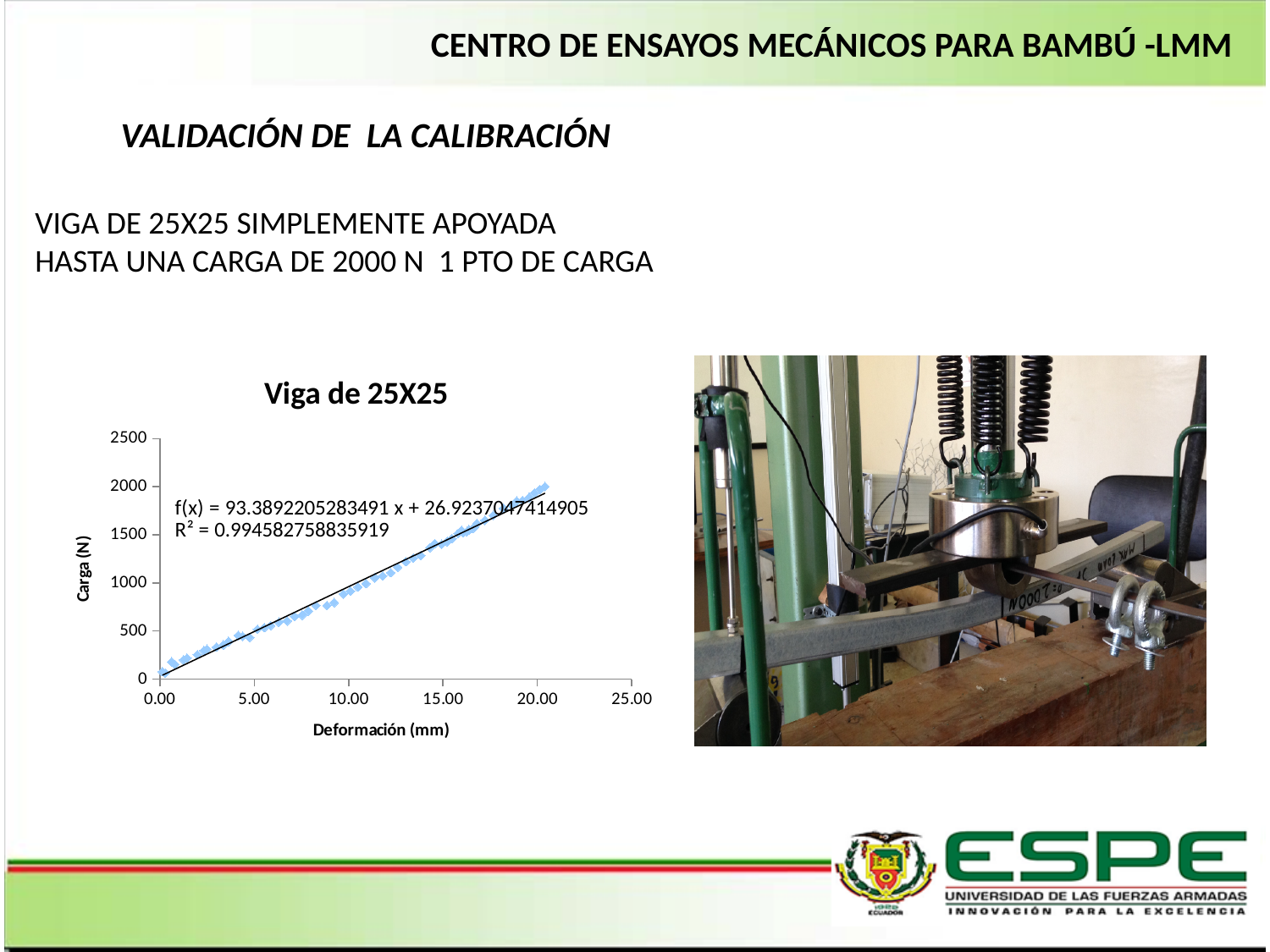
What kind of chart is shown on the slide? scatter chart What is the label of the x axis of the chart? Deformación (mm) What is the title of the chart? Viga de 25X25 What is the slope of the trendline equation shown on the chart? 93.3892205283491 What is the highest value shown on the y axis of the chart? 2500 What is the intercept of the trendline equation shown on the chart? 26.9237047414905 Is the load at a deformation of about 5 mm greater or less than 1000 N? less Is the load at a deformation of about 20 mm greater or less than 1500 N? greater Does the load (Carga) rise or fall as deformation increases along the x axis? rise Is the load at a deformation of about 10 mm greater or less than 500 N? greater What is the R² value shown on the chart? 0.994582758835919